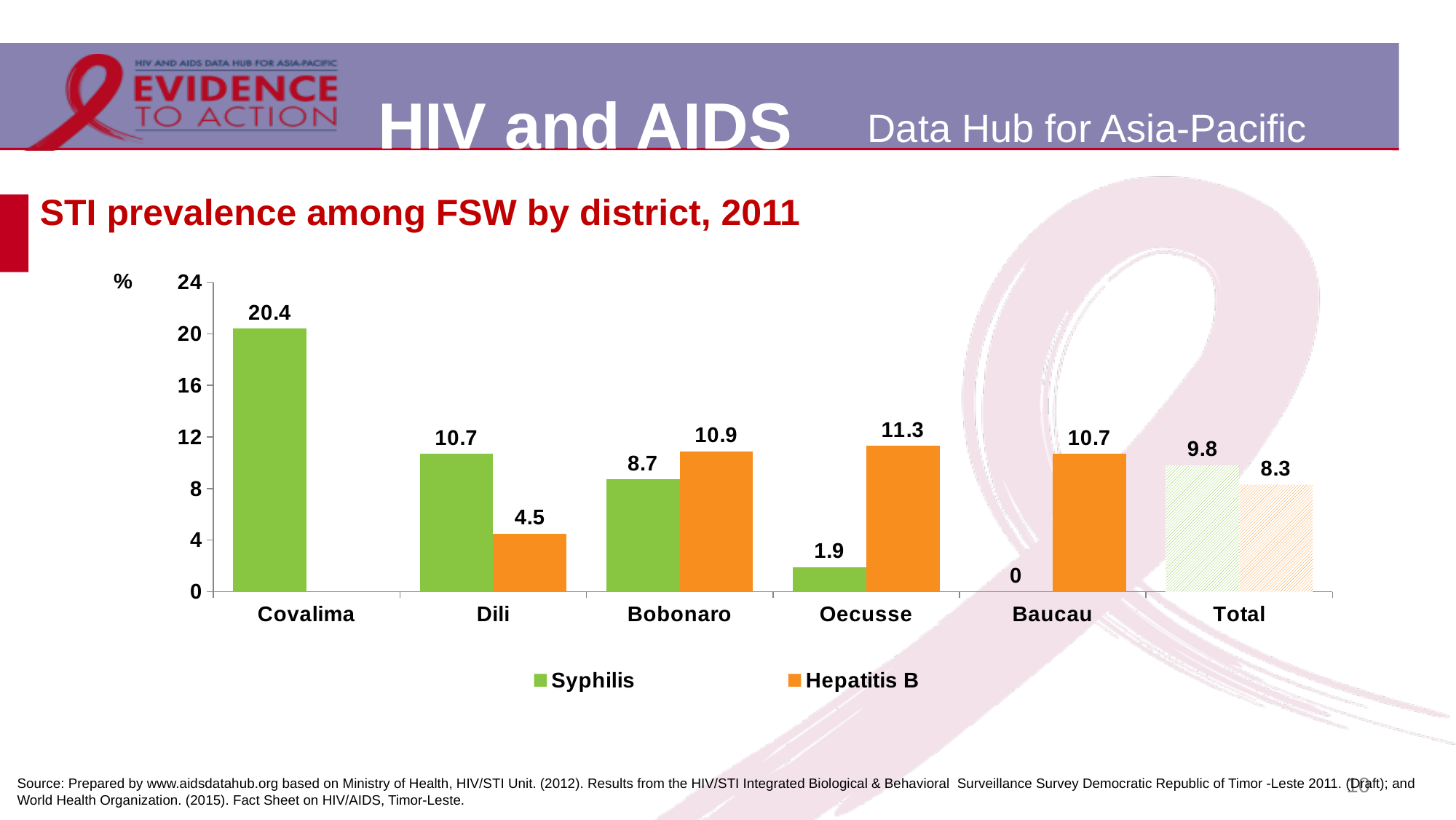
What is the Syphilis prevalence for Covalima? 20.4 Which district has the lowest Hepatitis B prevalence among those with a Hepatitis B bar? Dili What is the Hepatitis B prevalence for Oecusse? 11.3 Is the Syphilis value for Covalima greater or less than 16? greater What is the title of the chart? STI prevalence among FSW by district, 2011 In Bobonaro, which is larger: Syphilis or Hepatitis B prevalence? Hepatitis B What is the Syphilis prevalence for Baucau? 0 How many categories are shown on the x axis? 6 What kind of chart is shown on the slide? Bar chart Which district has the highest Syphilis prevalence? Covalima What is the difference between the Syphilis and Hepatitis B prevalence in Dili? 6.2 How many series does the legend list? 2